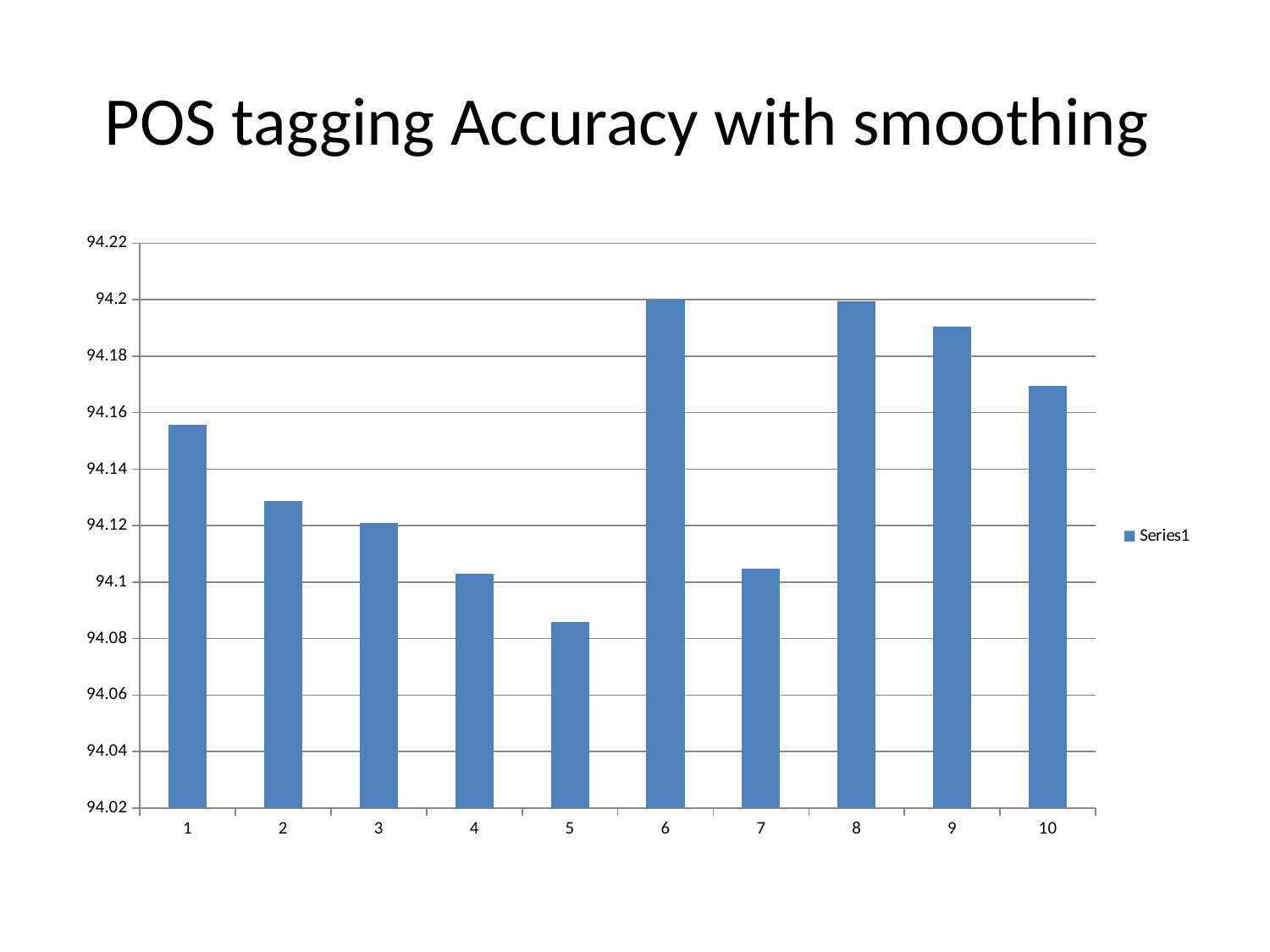
How many categories are plotted along the x axis? 10 What is the title of the chart? POS tagging Accuracy with smoothing How many series does the legend list? 1 Is the value for category 10 greater or less than 94.18? less What is the name of the series shown in the legend? Series1 Which category has the lowest value? 5 Is the value for category 9 greater or less than 94.18? greater Which has the larger value, category 6 or category 7? 6 Which has the larger value, category 1 or category 2? 1 Is the value for category 5 greater or less than 94.1? less What kind of chart is shown on the slide? bar chart